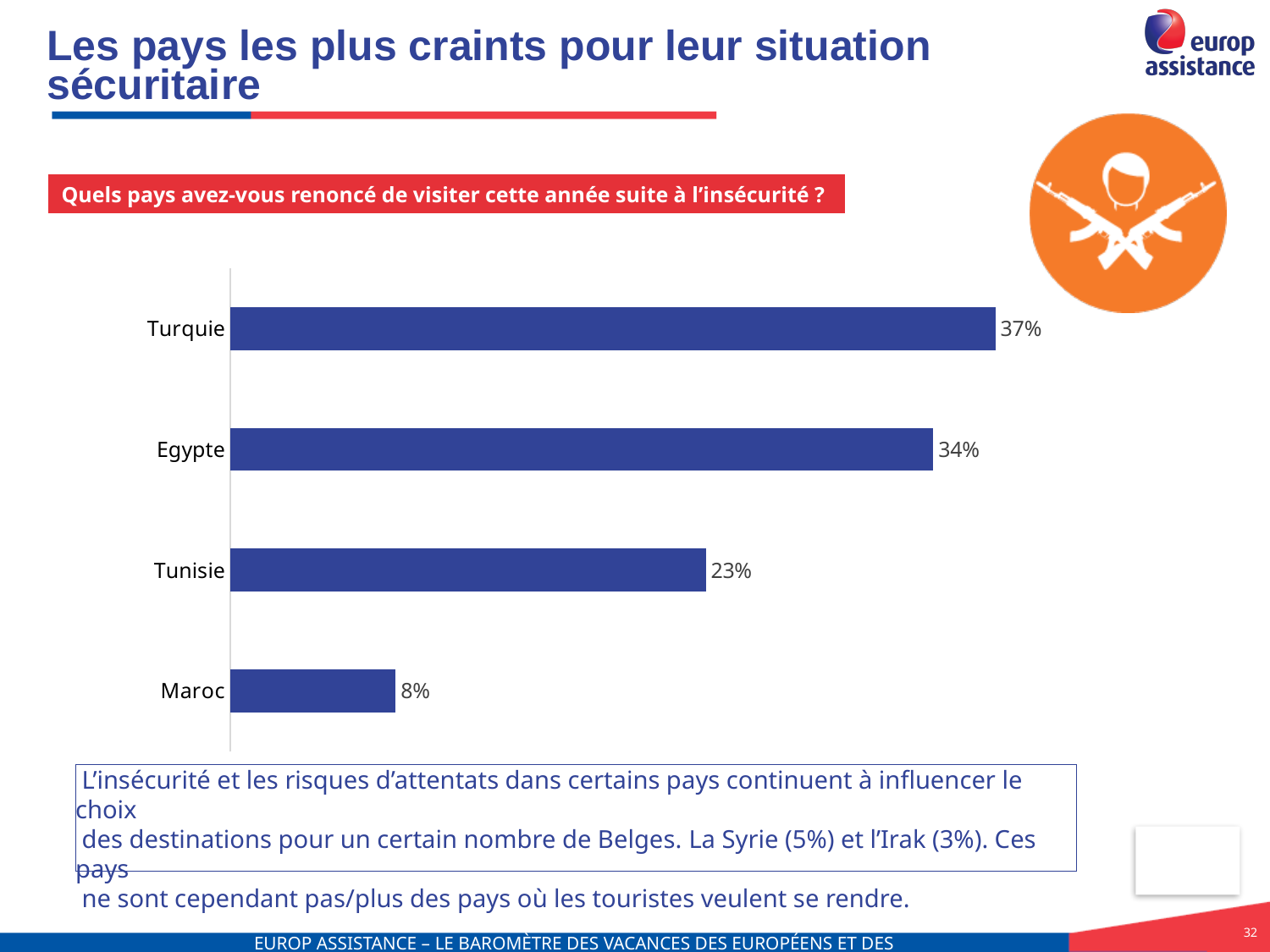
Which country has the highest value? Turquie What is the value for Egypte? 34% What question is the chart answering, as shown in the red box above it? Quels pays avez-vous renoncé de visiter cette année suite à l'insécurité ? What kind of chart is shown on the slide? Bar chart What is the difference between the values for Tunisie and Maroc? 15% What is the value for Maroc? 8% How many countries are shown in the chart? 4 Which country has the lowest value? Maroc What is the value for Turquie? 37% What is the difference between the values for Turquie and Egypte? 3% Which has a larger value, Egypte or Tunisie? Egypte What is the value for Tunisie? 23%